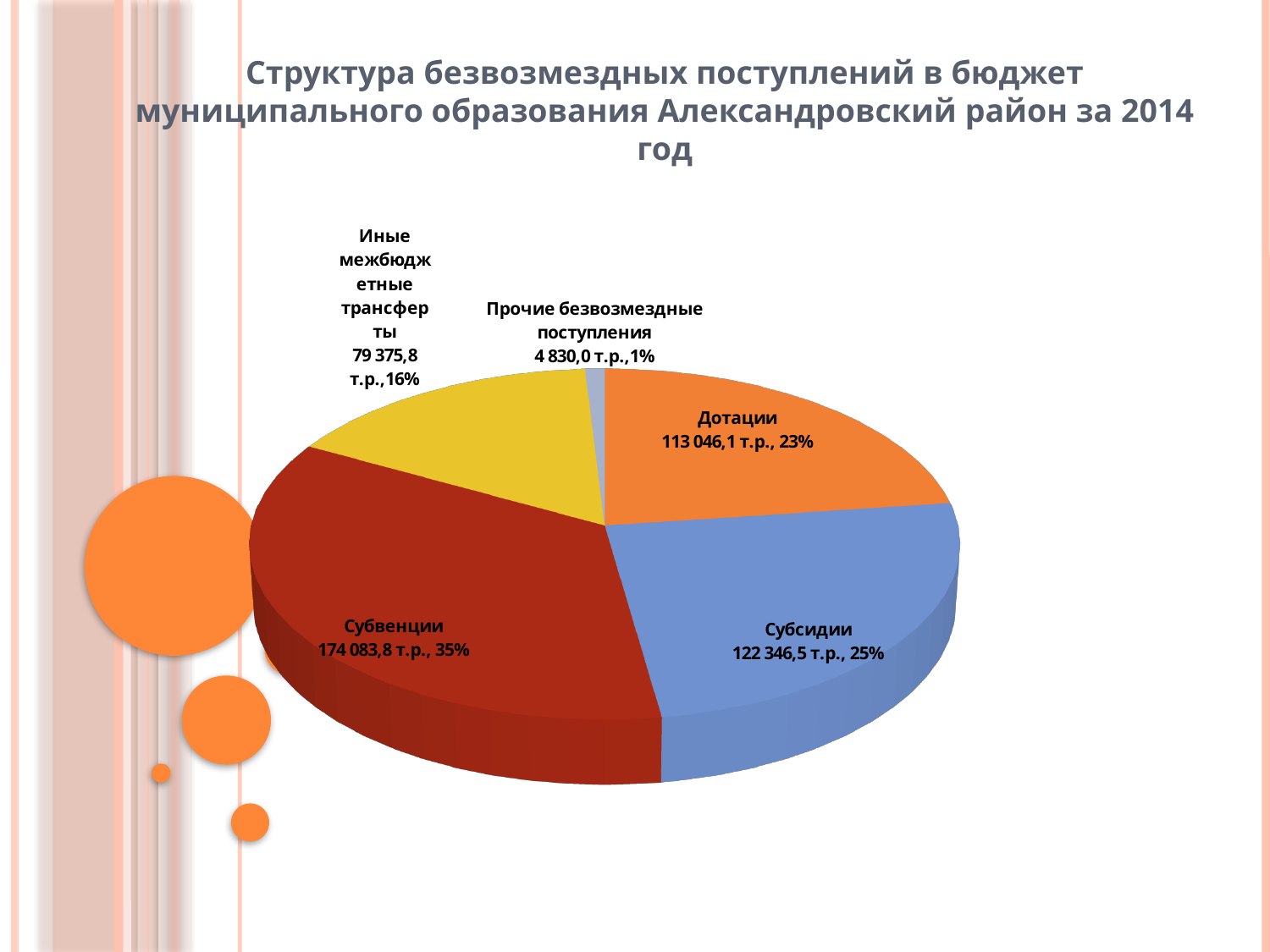
What is the value for Дотации? 113 046,1 т.р. What type of chart is shown on the slide? Pie chart What share of the pie does Субсидии represent? 25% Which is larger, Субсидии or Дотации? Субсидии Which category has the largest slice? Субвенции What is the value for Иные межбюджетные трансферты? 79 375,8 т.р. What is the value for Прочие безвозмездные поступления? 4 830,0 т.р. How many slices does the pie chart have? 5 What is the difference in value between Субвенции and Субсидии? 51 737,3 т.р. What share of the pie does Иные межбюджетные трансферты represent? 16% Which category has the smallest slice? Прочие безвозмездные поступления What is the value for Субвенции? 174 083,8 т.р.